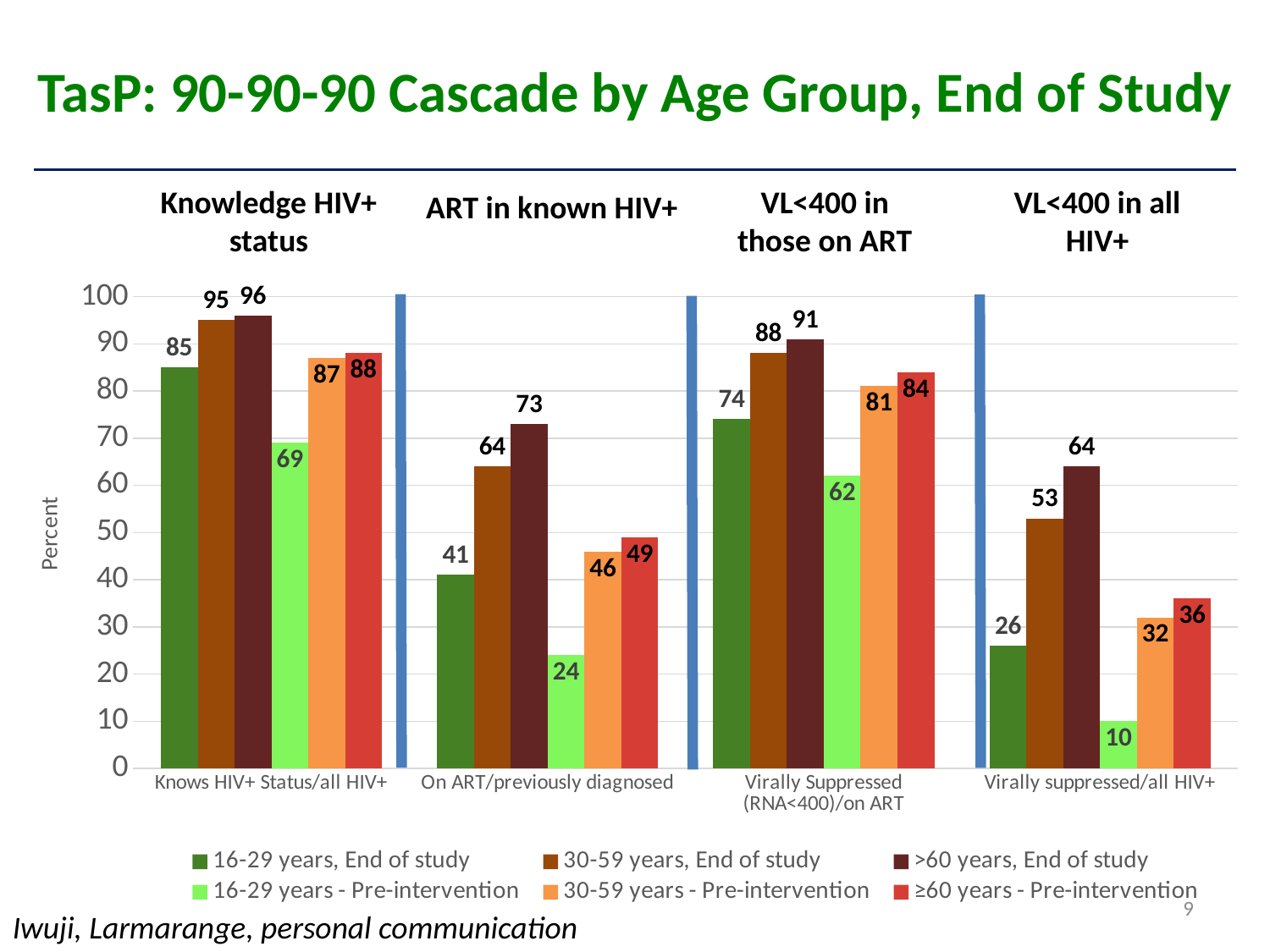
What is the value for 30-59 years - Pre-intervention in the Virally Suppressed (RNA<400)/on ART category? 81 What kind of chart is shown on the slide? bar chart Which is larger in the Knows HIV+ Status/all HIV+ category: 30-59 years, End of study or 30-59 years - Pre-intervention? 30-59 years, End of study How many series does the legend list? 6 Which series has the lowest value in the On ART/previously diagnosed category? 16-29 years - Pre-intervention What is the value for 16-29 years - Pre-intervention in the Virally suppressed/all HIV+ category? 10 Which series has the highest value in the Virally suppressed/all HIV+ category? >60 years, End of study What is the difference between the >60 years, End of study and 16-29 years, End of study values in the On ART/previously diagnosed category? 32 What is the value for >60 years, End of study in the On ART/previously diagnosed category? 73 How many categories are shown on the x axis? 4 What is the label of the y axis? Percent What is the value for 16-29 years, End of study in the Knows HIV+ Status/all HIV+ category? 85